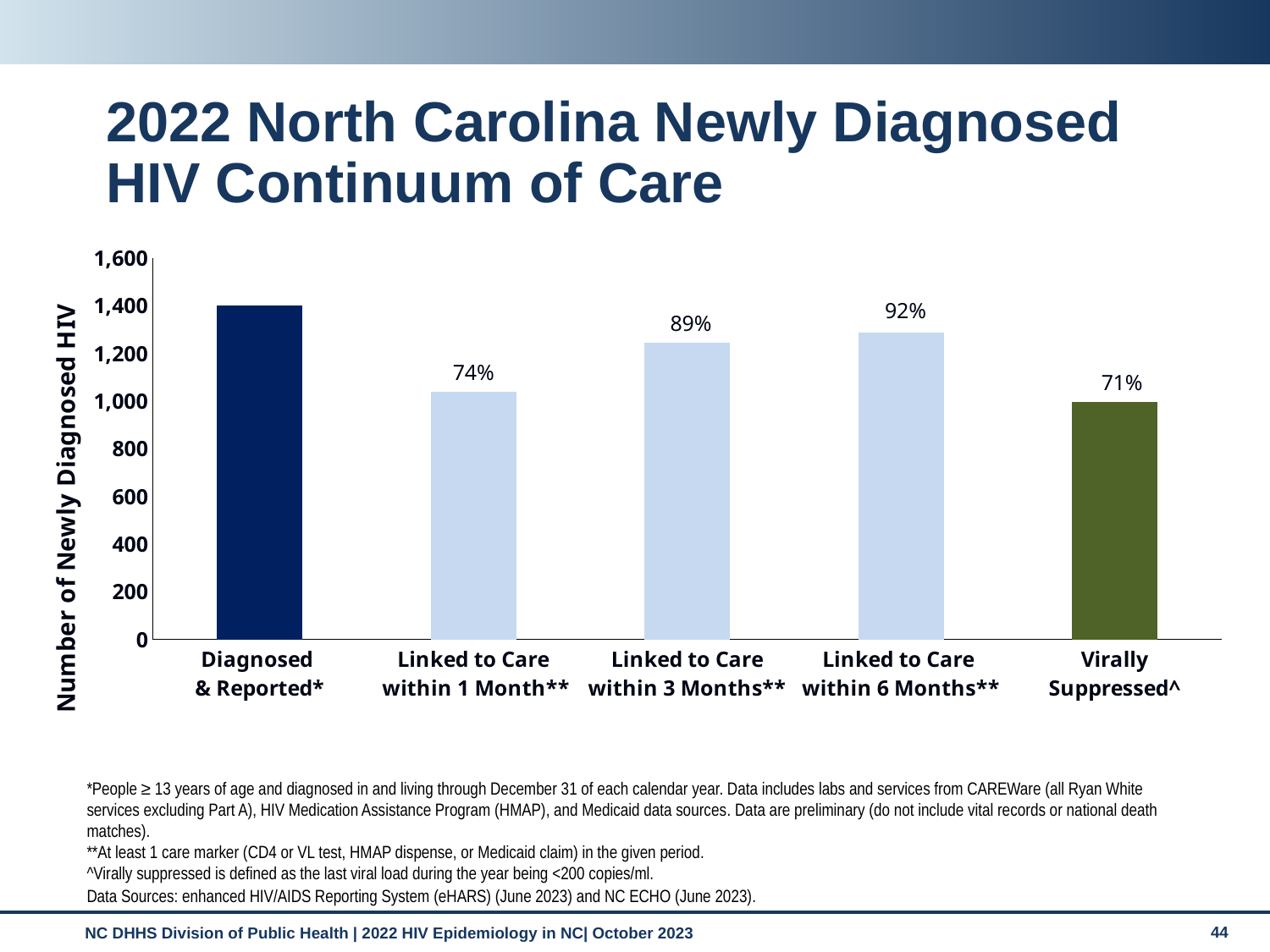
What percentage label is shown on the 'Linked to Care within 1 Month**' bar? 74% What percentage label is shown on the 'Linked to Care within 6 Months**' bar? 92% What type of chart is shown on the slide? Bar chart Among the bars with percentage labels, which category has the lowest percentage? Virally Suppressed^ Which is larger: the percentage for 'Linked to Care within 3 Months**' or for 'Virally Suppressed^'? Linked to Care within 3 Months** What is the difference in percentage points between 'Linked to Care within 6 Months**' and 'Linked to Care within 1 Month**'? 18 percentage points What percentage label is shown on the 'Virally Suppressed^' bar? 71% How many categories are shown on the x axis of the chart? 5 Is the value for 'Diagnosed & Reported*' greater or less than 1,200? greater Is the value for 'Linked to Care within 1 Month**' greater or less than 1,200? less Among the bars with percentage labels, which category has the highest percentage? Linked to Care within 6 Months** What percentage label is shown on the 'Linked to Care within 3 Months**' bar? 89%